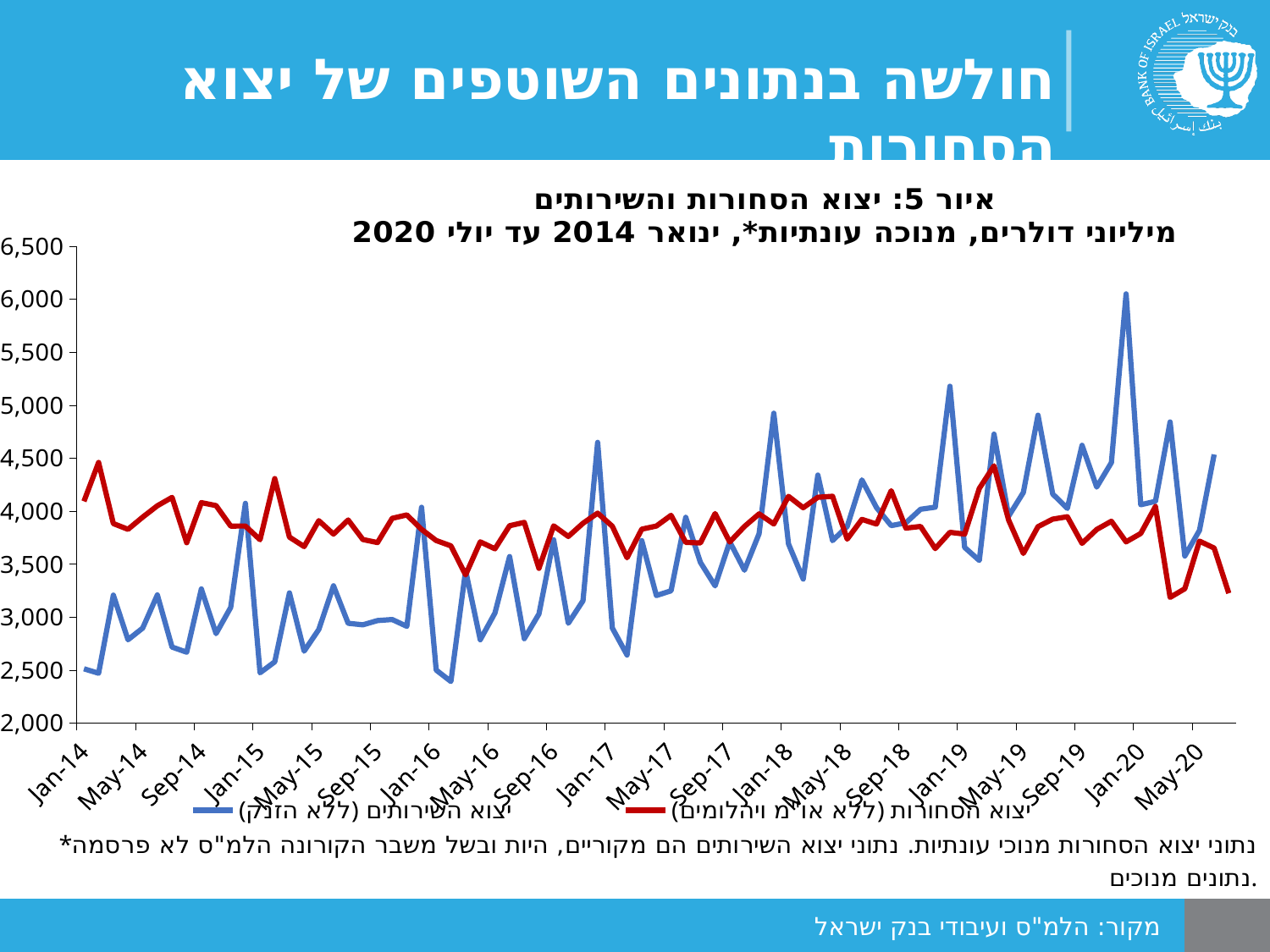
Is the final value of the goods exports (red) series, at the right end of the chart, greater or less than 3,500? less How many series does the legend list? 2 What kind of chart is shown on the slide? line chart Is the highest value reached by the services exports (blue) series greater or less than 5,500? greater What is the highest tick value shown on the y axis? 6,500 At Jan-20, which series has the higher value, services exports or goods exports? services exports Is the value of the goods exports (red) series at Jan-14 greater or less than 3,500? greater What colour is the line for goods exports (יצוא הסחורות)? red Does the services exports (blue) series generally rise or fall from Jan-14 to Jan-20? rise Which series reaches the highest value anywhere on the chart? services exports (blue) At Jan-14, which series has the higher value, services exports or goods exports? goods exports